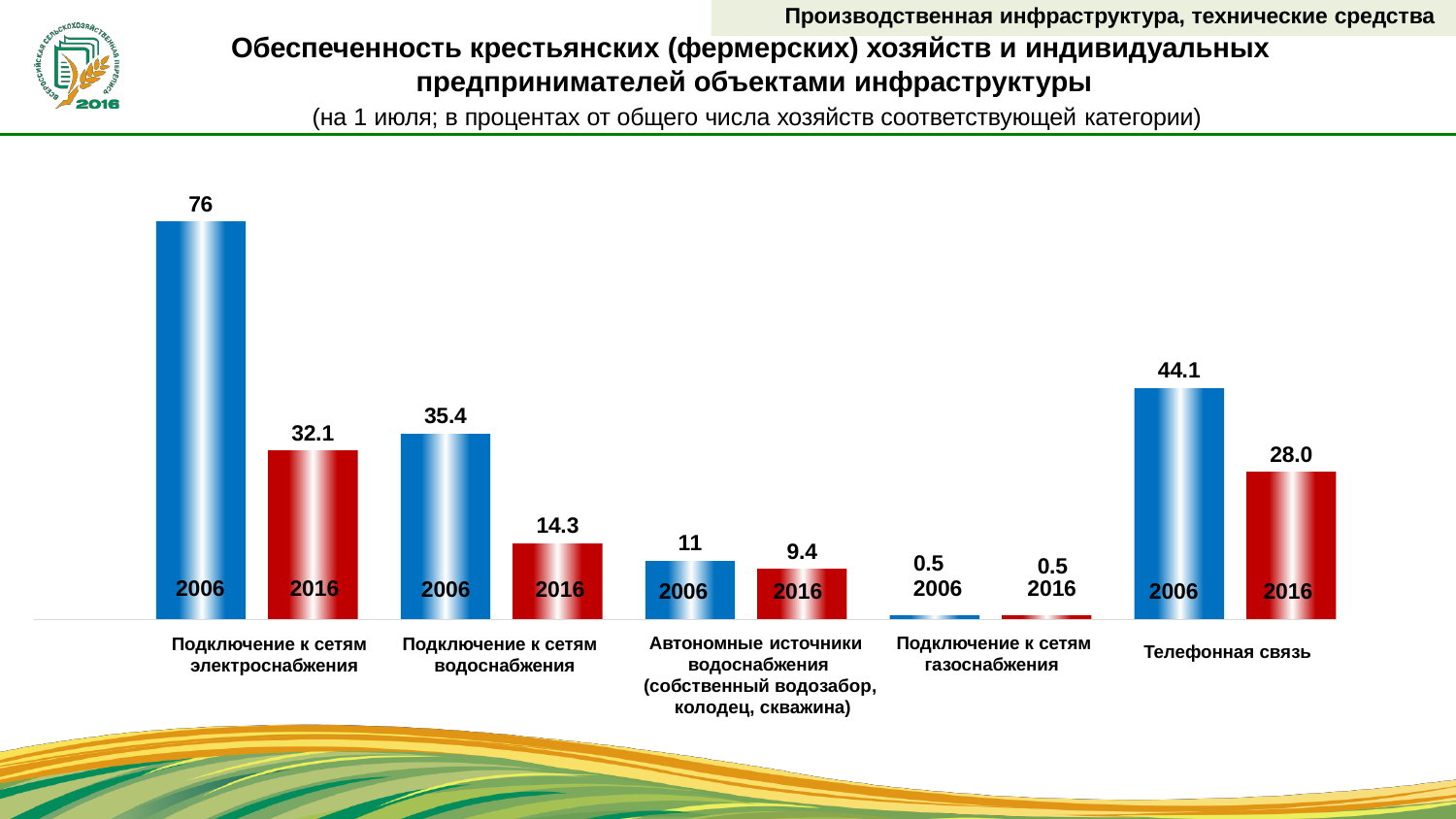
What is the 2016 value for «Телефонная связь»? 28.0 What kind of chart is shown on the slide? Bar chart What is the difference between the 2006 and 2016 values for «Подключение к сетям электроснабжения»? 43.9 What is the 2006 value for «Подключение к сетям электроснабжения»? 76 Which two years are compared in the chart? 2006 and 2016 What is the 2006 value for «Автономные источники водоснабжения (собственный водозабор, колодец, скважина)»? 11 How many categories are shown on the x axis of the chart? 5 Which is larger: the 2016 value for «Подключение к сетям электроснабжения» or the 2016 value for «Телефонная связь»? Подключение к сетям электроснабжения What is the difference between the 2006 and 2016 values for «Телефонная связь»? 16.1 Which category has the highest 2006 value? Подключение к сетям электроснабжения What is the 2016 value for «Подключение к сетям водоснабжения»? 14.3 Which category has the lowest 2016 value? Подключение к сетям газоснабжения